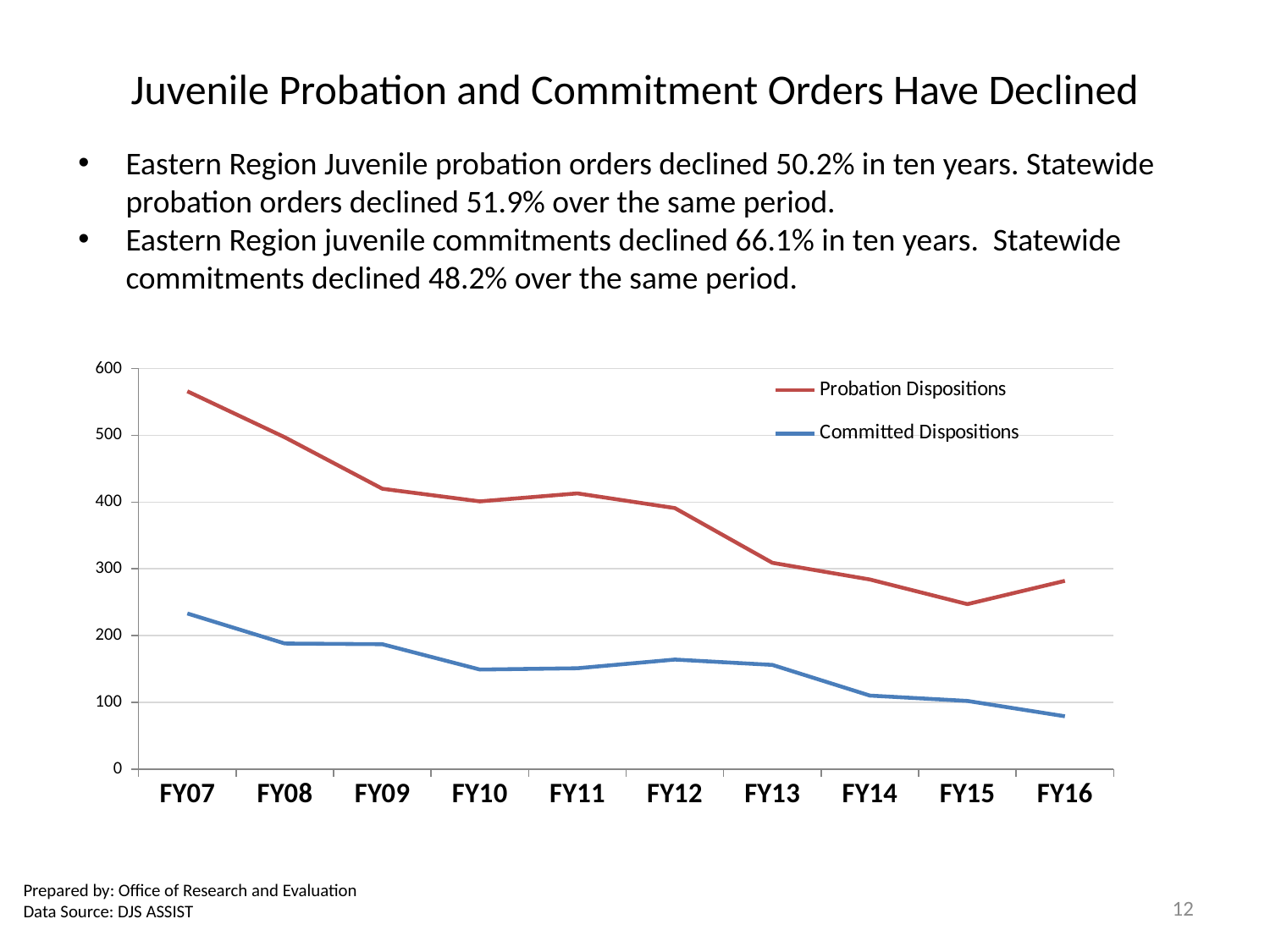
What kind of chart is shown on the slide? line chart Is the value for Probation Dispositions in FY07 greater or less than 500? greater Which series has the larger value in FY12, Probation Dispositions or Committed Dispositions? Probation Dispositions In which fiscal year is the Probation Dispositions line at its lowest? FY15 Is the value for Probation Dispositions in FY15 greater or less than 300? less Overall, do the Committed Dispositions values rise or fall from FY07 to FY16? fall How many fiscal years are plotted along the x axis? 10 Is the value for Committed Dispositions in FY07 greater or less than 200? greater In which fiscal year is the Committed Dispositions line at its lowest? FY16 How many series does the legend list? 2 In which fiscal year is the Probation Dispositions line at its highest? FY07